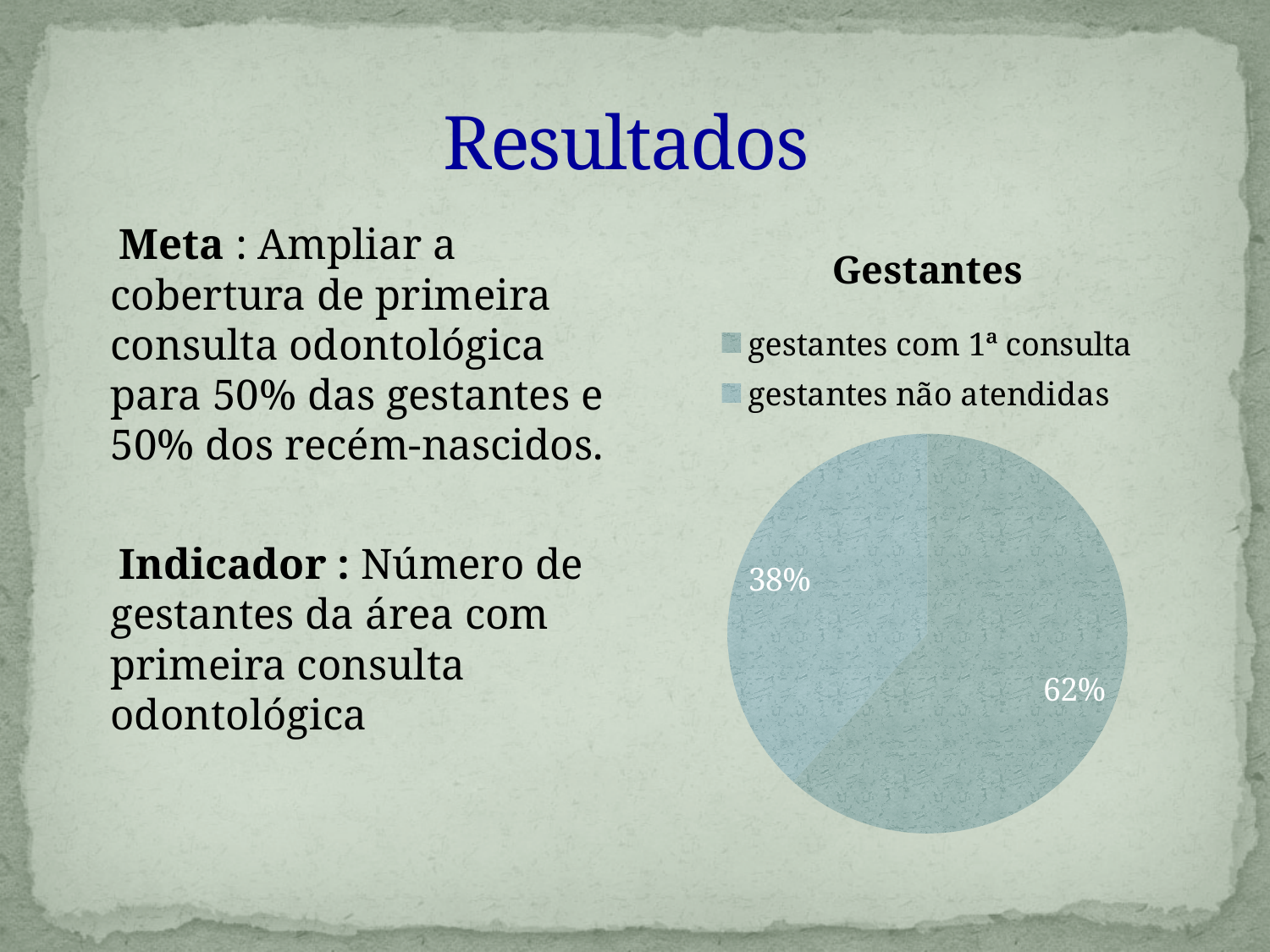
What is the difference in percentage points between the two slices of the pie chart? 24 What is the title of the chart on the slide? Gestantes How many entries does the chart legend list? 2 What is the share of the largest slice in the pie chart? 62% Which slice is larger in the pie chart, the one labelled 62% or the one labelled 38%? 62% Is the largest slice of the pie chart greater or less than 50%? greater What are the two legend entries of the chart? gestantes com 1ª consulta; gestantes não atendidas What do the two slice percentages in the pie chart add up to? 100% How many slices does the pie chart have? 2 What kind of chart is shown on the slide? pie chart What is the share of the smallest slice in the pie chart? 38%